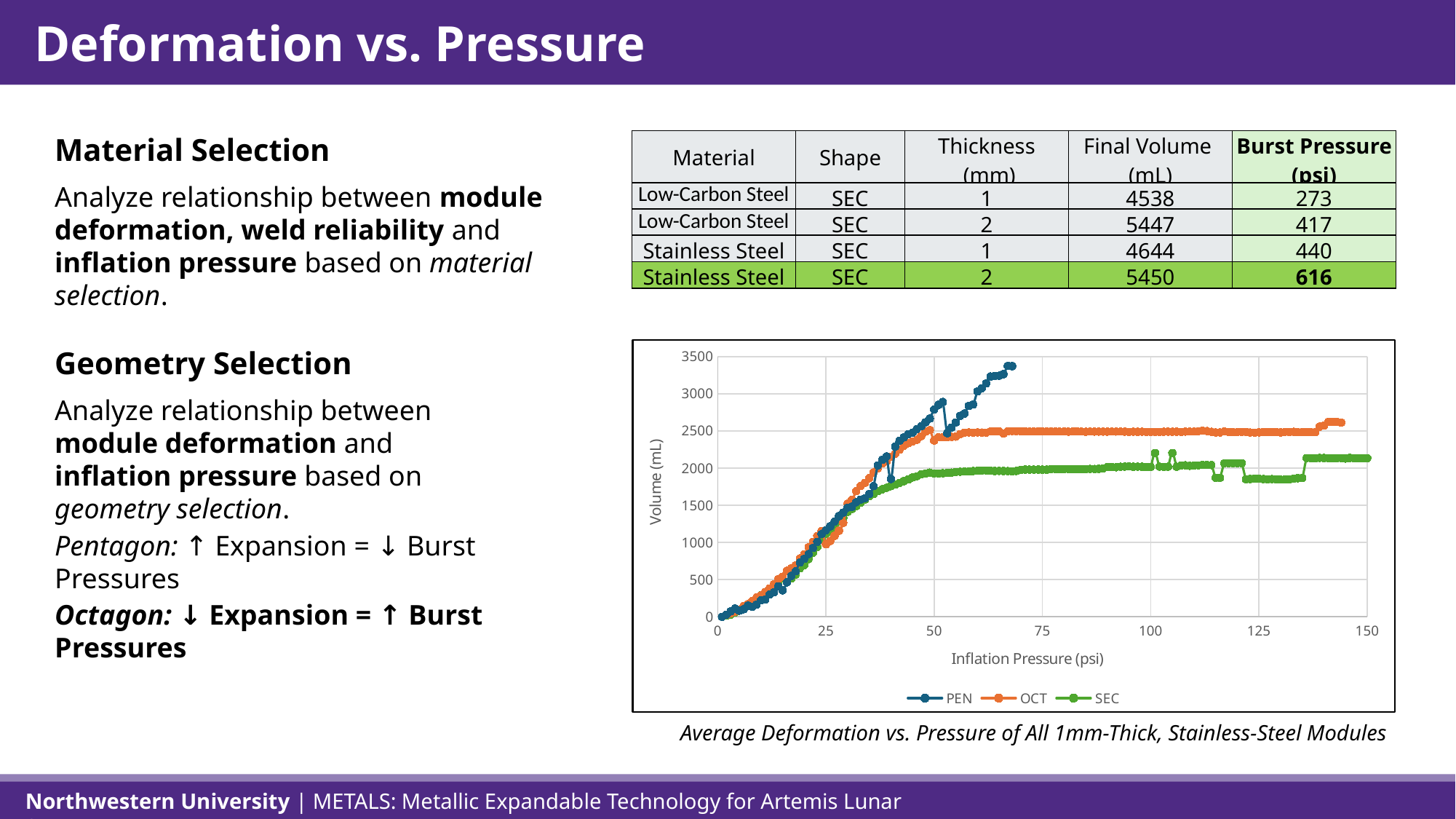
Which series ends at the lowest inflation pressure on the chart? PEN Does the volume rise or fall as inflation pressure increases along the x axis? rise What is the label of the chart's vertical axis? Volume (mL) Is the volume of the OCT series at 100 psi greater or less than 2000? greater Is the volume of the SEC series at 100 psi greater or less than 2500? less Is the highest volume reached by the PEN series greater or less than 3000? greater At an inflation pressure of 100 psi, which series has the higher volume, OCT or SEC? OCT Which series reaches the highest volume on the chart? PEN Which series levels off at the lowest volume on the chart? SEC How many series does the chart's legend list? 3 What kind of chart is shown on the slide? line chart What are the series names listed in the chart's legend? PEN, OCT, SEC